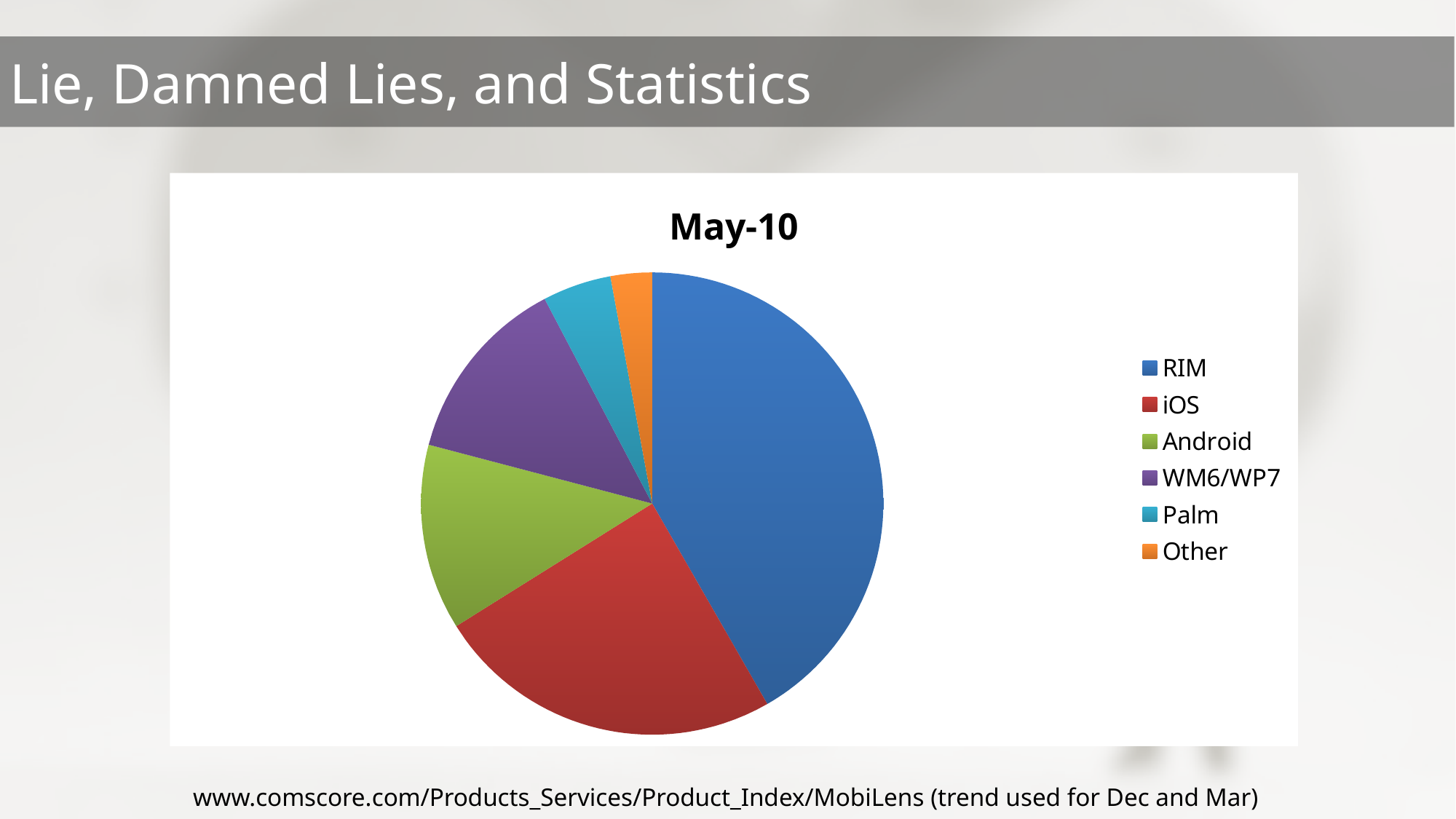
What kind of chart is shown on the slide? pie chart Which slice is larger, WM6/WP7 or Palm? WM6/WP7 Which slice is larger, iOS or Palm? iOS How many categories does the legend of the pie chart list? 6 Which slice is larger, iOS or Android? iOS Which category has the smallest slice of the pie? Other Which category is shown in blue in the pie chart? RIM Which category has the largest slice of the pie? RIM What is the title of the chart? May-10